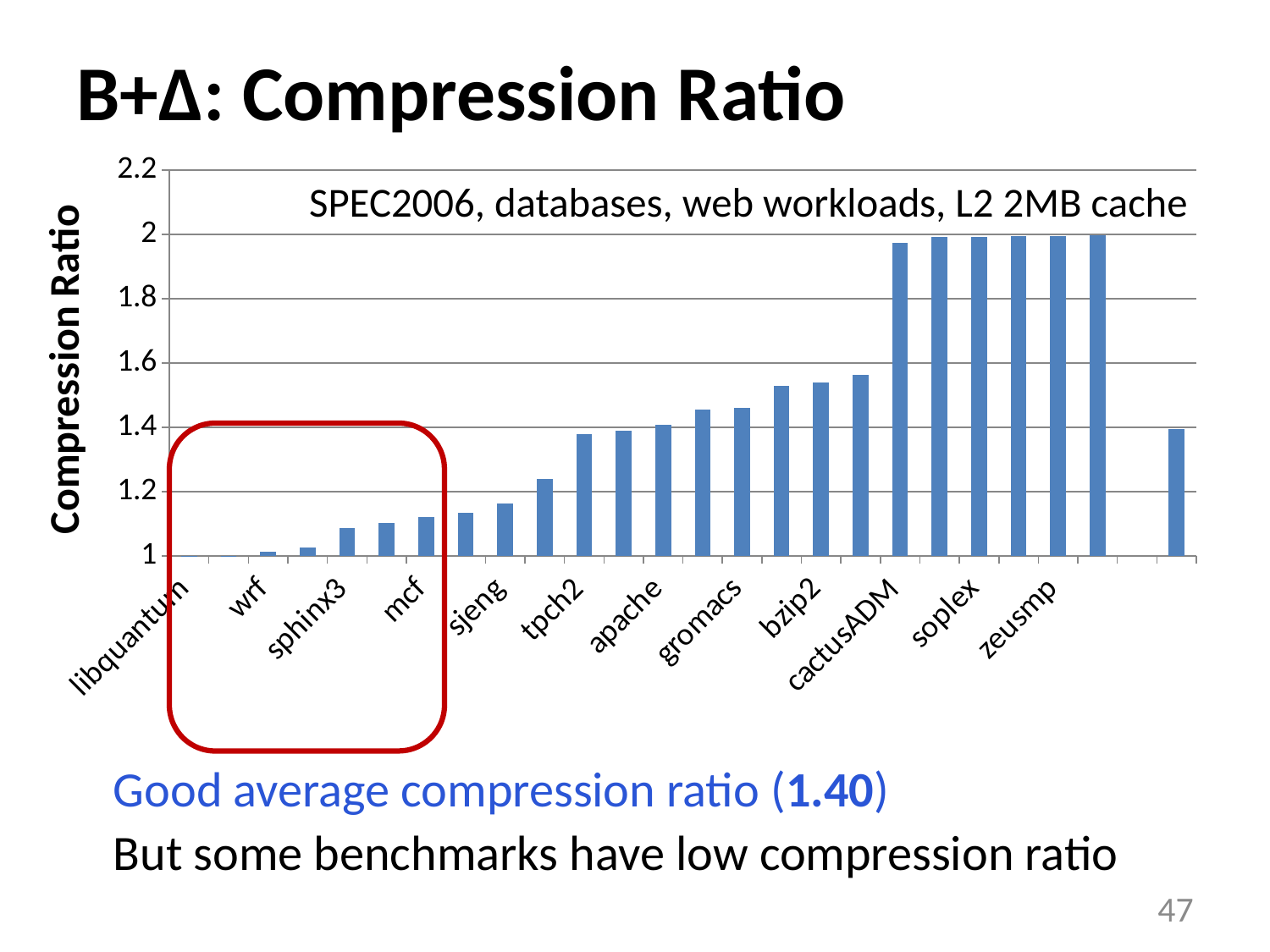
What workloads and cache configuration does the annotation inside the chart describe? SPEC2006, databases, web workloads, L2 2MB cache Is the compression ratio for cactusADM greater or less than 1.8? greater Do the compression ratios of the labeled benchmarks rise or fall from libquantum to zeusmp along the x axis? rise How many benchmark names are labeled on the x axis? 12 What kind of chart is shown on the slide? bar chart Is the compression ratio for zeusmp greater or less than 1.8? greater Is the compression ratio for wrf greater or less than 1.2? less What is the title of the y axis? Compression Ratio Which has the higher compression ratio, mcf or zeusmp? zeusmp Which has the higher compression ratio, sphinx3 or gromacs? gromacs